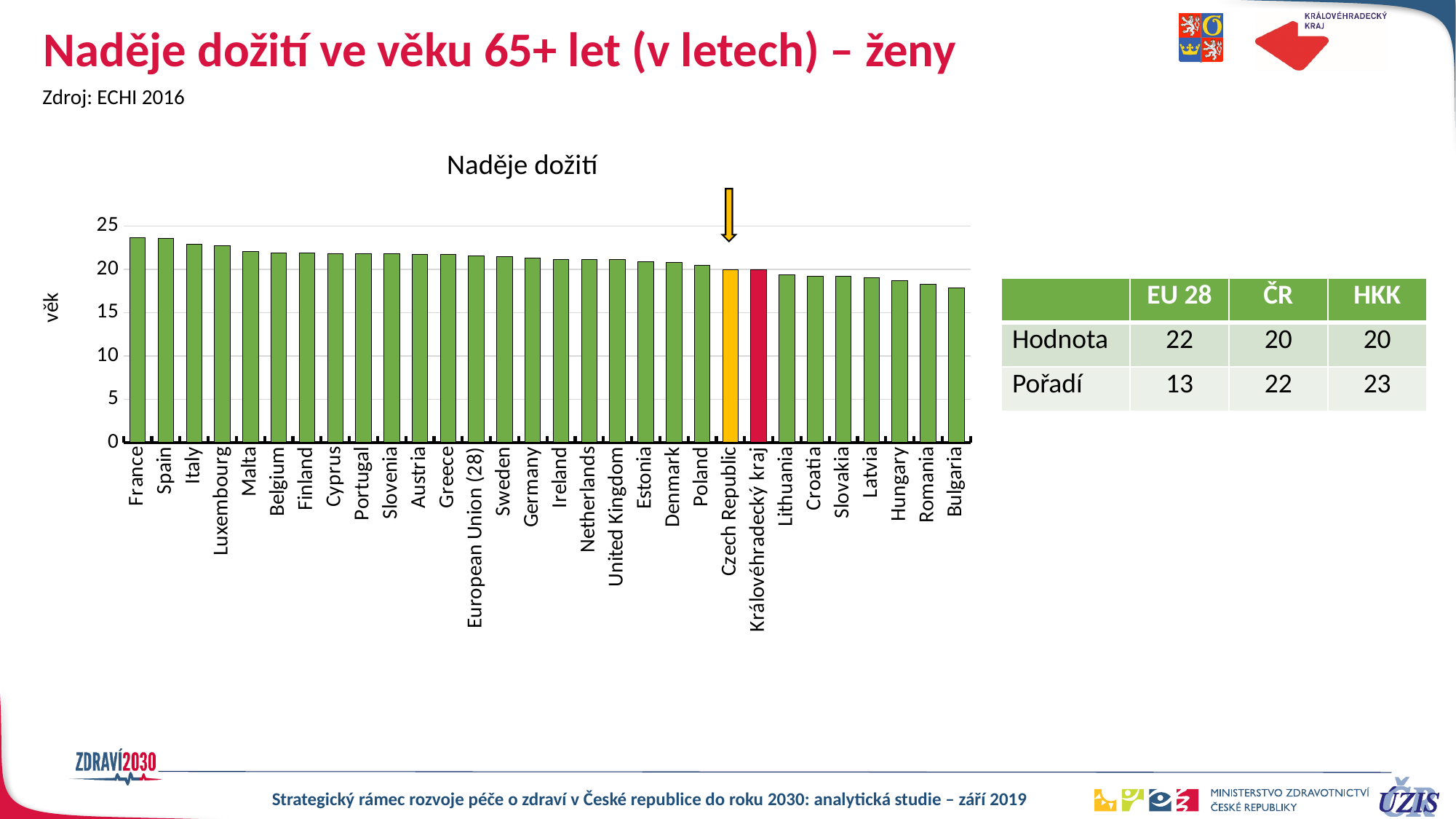
Is the value for France greater or less than 20? greater What kind of chart is shown on the slide? bar chart What is the title of the chart? Naděje dožití Do the values rise or fall moving from left to right along the x axis? fall Is the value for Bulgaria greater or less than 20? less Which has the larger value, France or Bulgaria? France Is the value for Hungary greater or less than 20? less What is the label on the vertical axis of the chart? věk How many countries/regions are plotted on the chart? 30 According to the table next to the chart, what is the Hodnota (value) for EU 28? 22 Which category has the lowest value on the chart? Bulgaria